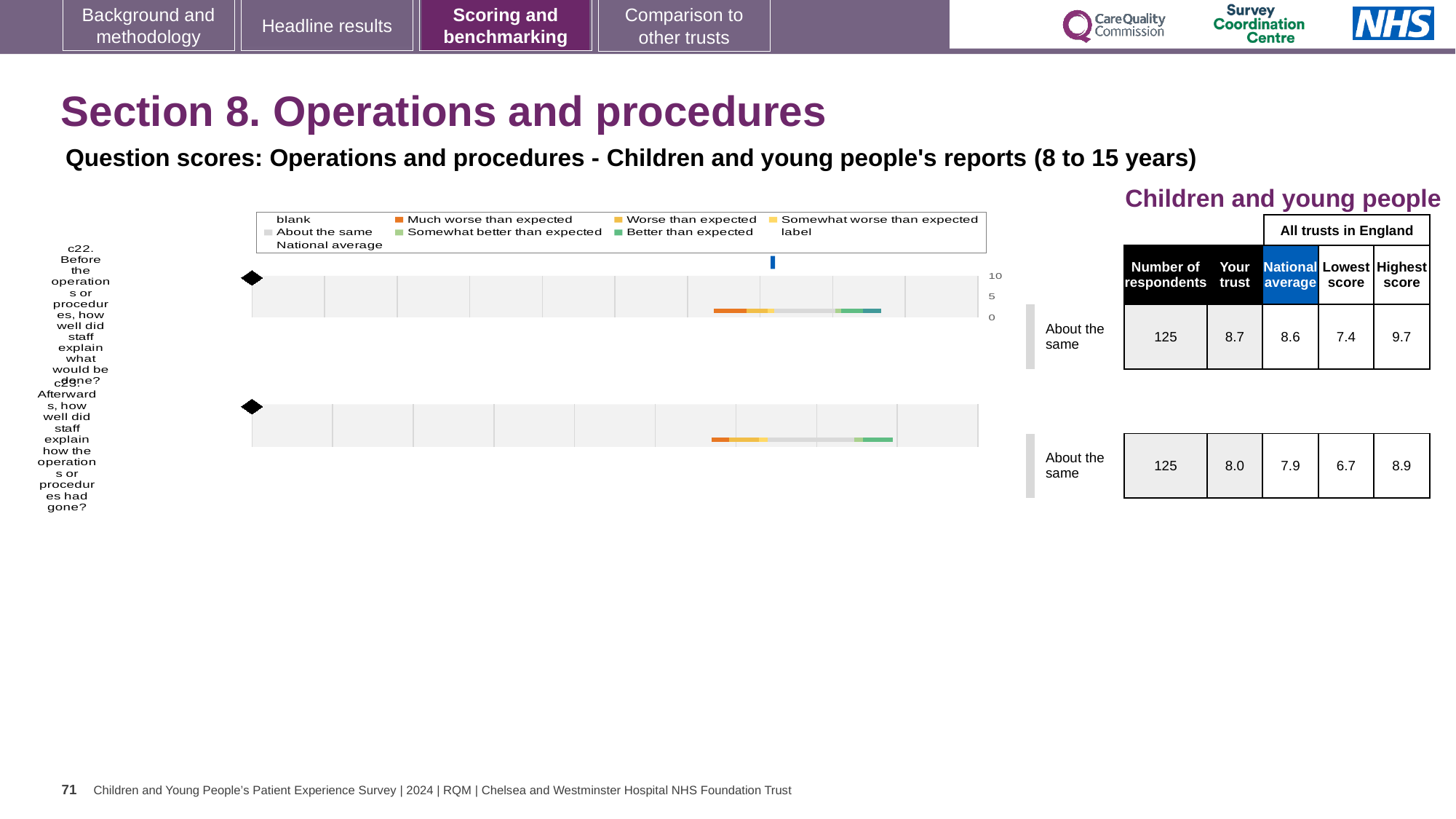
What is the national average score for question c22? 8.6 What is the difference between the highest and lowest trust scores for question c23? 2.2 What is the national average score for question c23? 7.9 Which question has the higher 'Your trust' score, c22 or c23? c22 What benchmark category is shown for question c22? About the same How many respondents answered question c23? 125 How many questions are charted on this slide? 2 What is the lowest score among all trusts in England for question c22? 7.4 What is the 'Your trust' score for question c22 (Before the operations or procedures, how well did staff explain what would be done?)? 8.7 What is the 'Your trust' score for question c23 (Afterwards, how well did staff explain how the operations or procedures had gone?)? 8.0 What is the highest score among all trusts in England for question c22? 9.7 What is the difference between the highest and lowest trust scores for question c22? 2.3